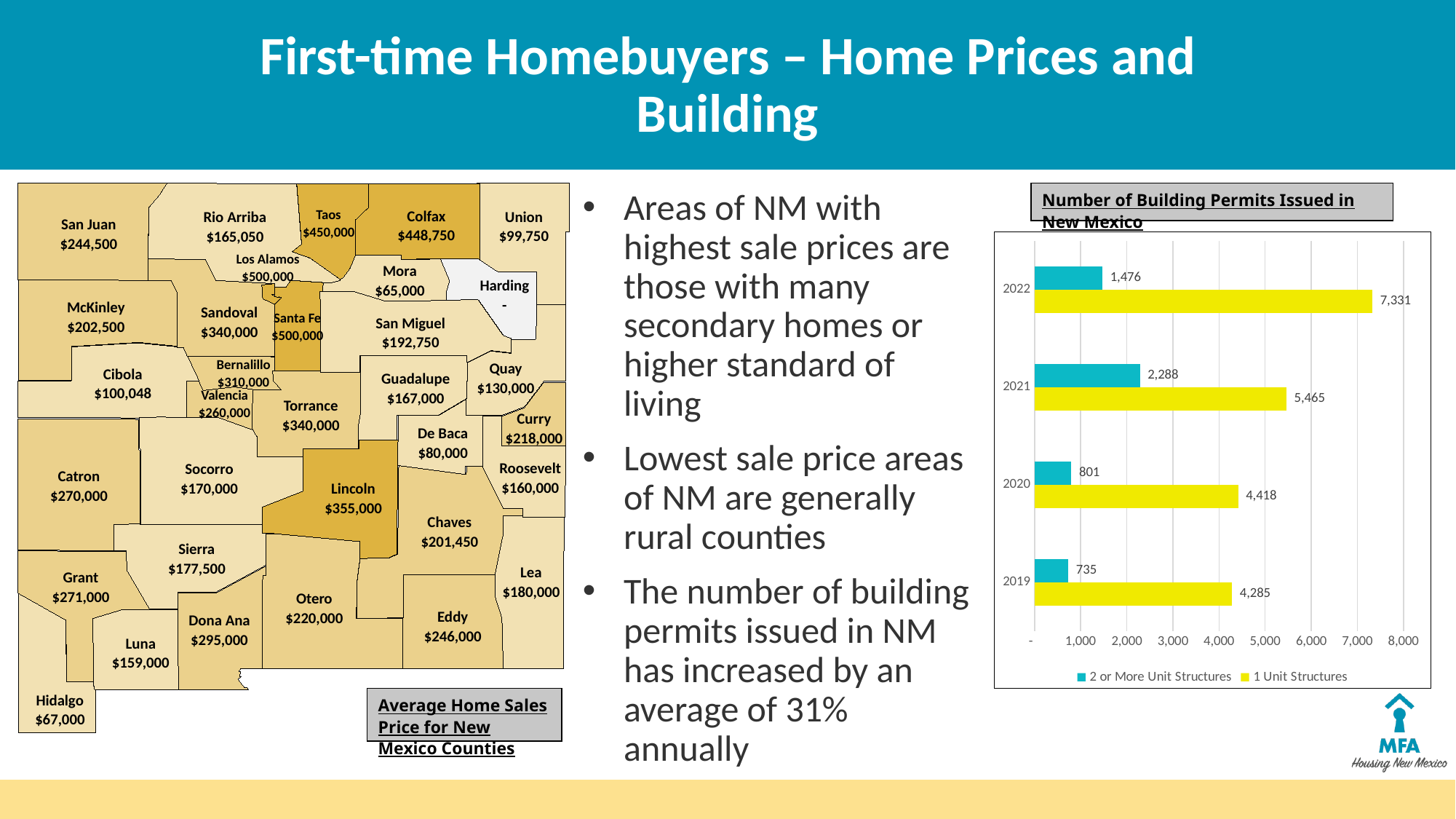
In the 'Number of Building Permits Issued in New Mexico' chart, what is the difference between the 1 Unit Structures values for 2022 and 2021? 1,866 In the 'Number of Building Permits Issued in New Mexico' chart, what is the value for 2 or More Unit Structures in 2021? 2,288 In the 'Number of Building Permits Issued in New Mexico' chart, how many series does the legend list? 2 In the 'Number of Building Permits Issued in New Mexico' chart, how many years are shown? 4 In the 'Number of Building Permits Issued in New Mexico' chart, how many permits were issued for 1 Unit Structures in 2022? 7,331 In the 'Number of Building Permits Issued in New Mexico' chart, which year has the lowest value for 2 or More Unit Structures? 2019 What kind of chart is the 'Number of Building Permits Issued in New Mexico' chart? Bar chart In the 'Number of Building Permits Issued in New Mexico' chart, what is the value for 1 Unit Structures in 2019? 4,285 In the 'Number of Building Permits Issued in New Mexico' chart, which year has the larger value for 2 or More Unit Structures, 2020 or 2019? 2020 In the 'Number of Building Permits Issued in New Mexico' chart, how much larger is the 1 Unit Structures value than the 2 or More Unit Structures value in 2022? 5,855 In the 'Number of Building Permits Issued in New Mexico' chart, which year has the highest value for 1 Unit Structures? 2022 In the 'Number of Building Permits Issued in New Mexico' chart, do the 1 Unit Structures values rise or fall from 2019 to 2022? Rise